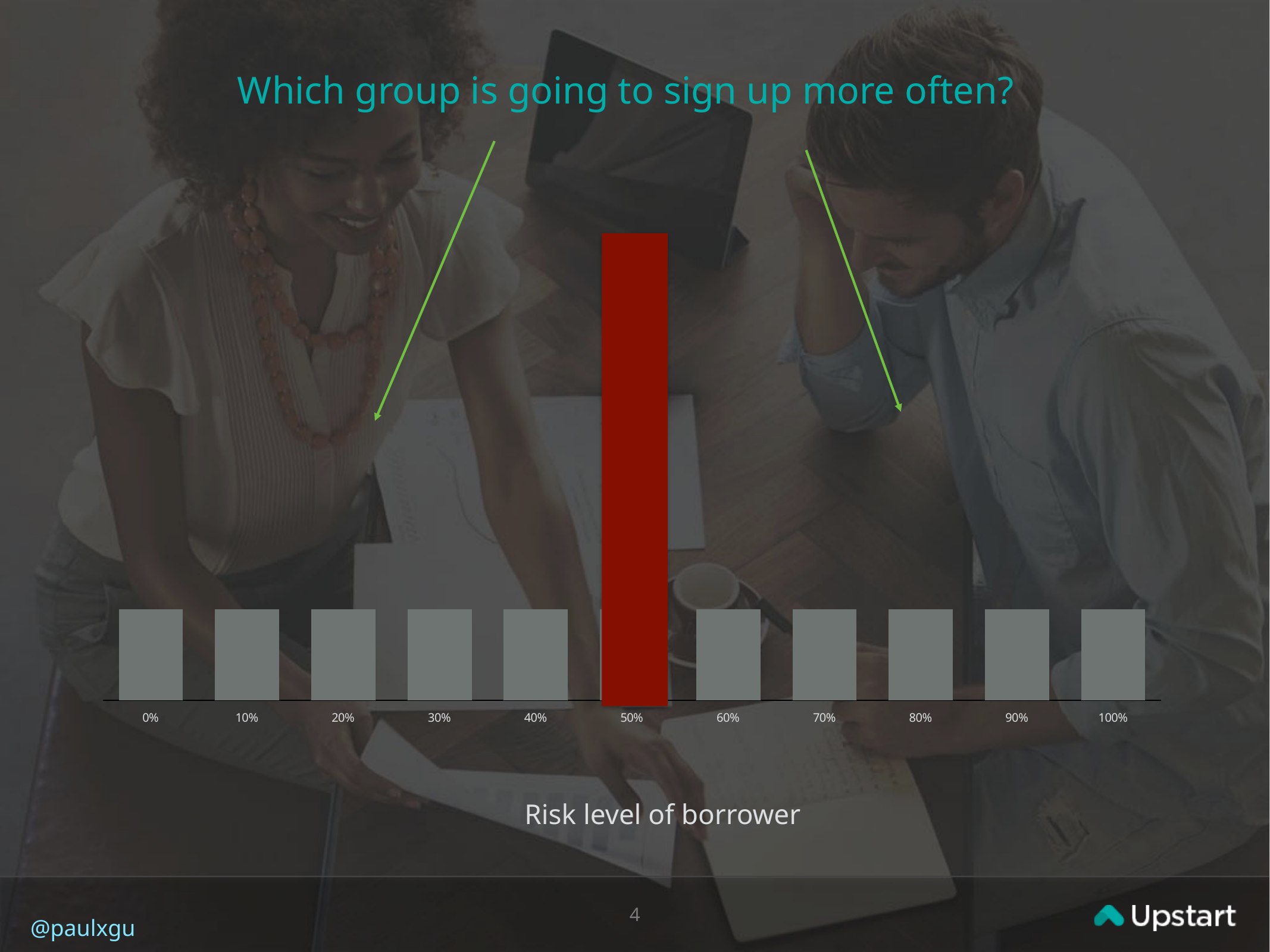
What kind of chart is shown on the slide? bar chart What is the last category label on the x axis? 100% What is the label of the x axis? Risk level of borrower What is the first category label on the x axis? 0% Which is larger, the value for 50% or the value for 90%? 50% How many bars (categories) are plotted along the x axis? 11 Which risk level category has the tallest bar? 50% Is the bar for 50% taller or shorter than the bar for 20%? taller